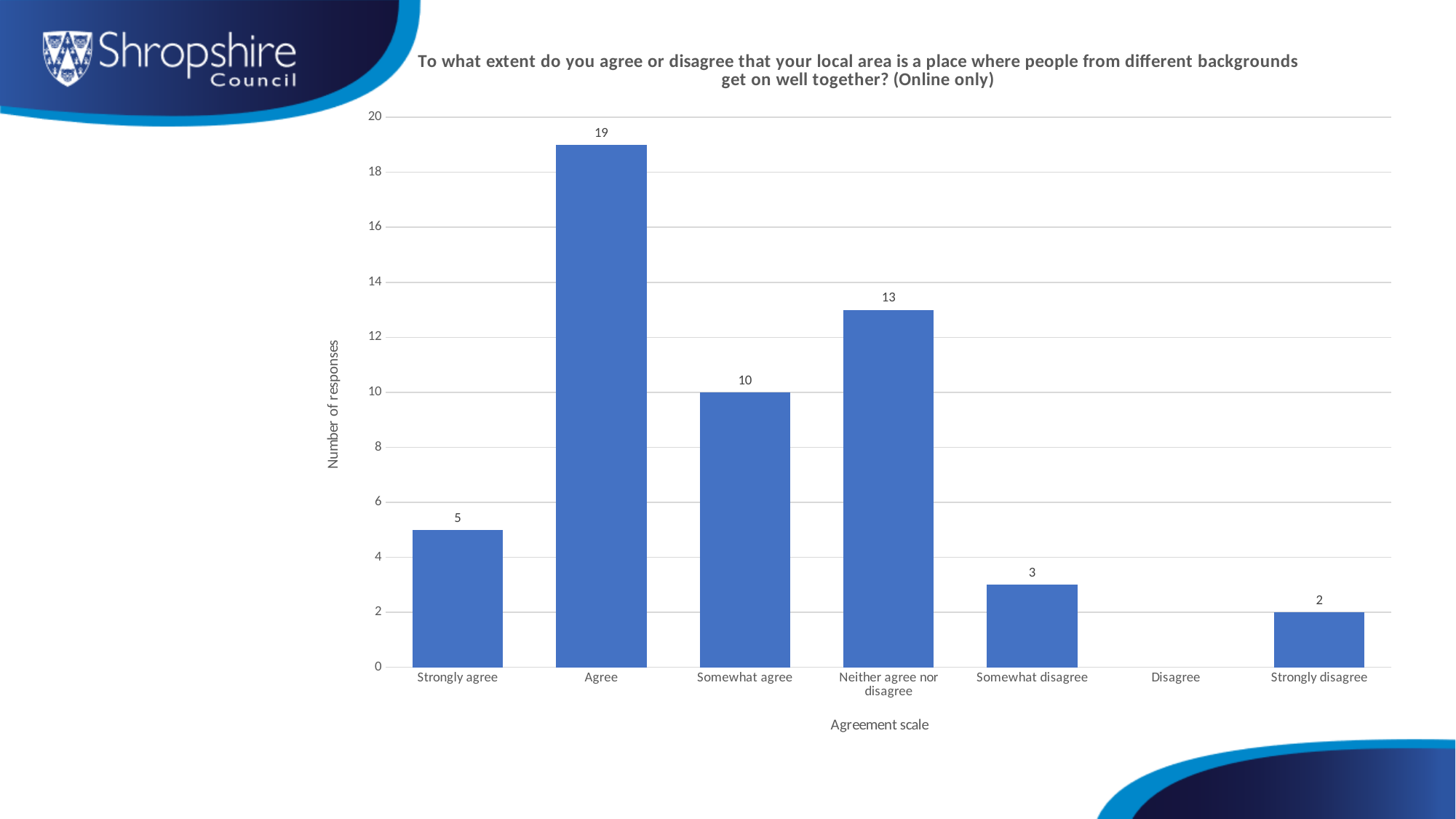
How many responses were recorded for "Strongly disagree"? 2 What is the difference in responses between "Agree" and "Somewhat agree"? 9 Which agreement category received the most responses? Agree Which category with a visible bar has the fewest responses? Strongly disagree What is the number of responses for "Neither agree nor disagree"? 13 What is the difference in responses between "Neither agree nor disagree" and "Strongly agree"? 8 Which has more responses, "Somewhat agree" or "Somewhat disagree"? Somewhat agree What type of chart is shown on the slide? Bar chart What is the label of the x axis? Agreement scale How many agreement categories are shown on the x axis? 7 How many responses were recorded for "Agree"? 19 What is the label of the y axis? Number of responses